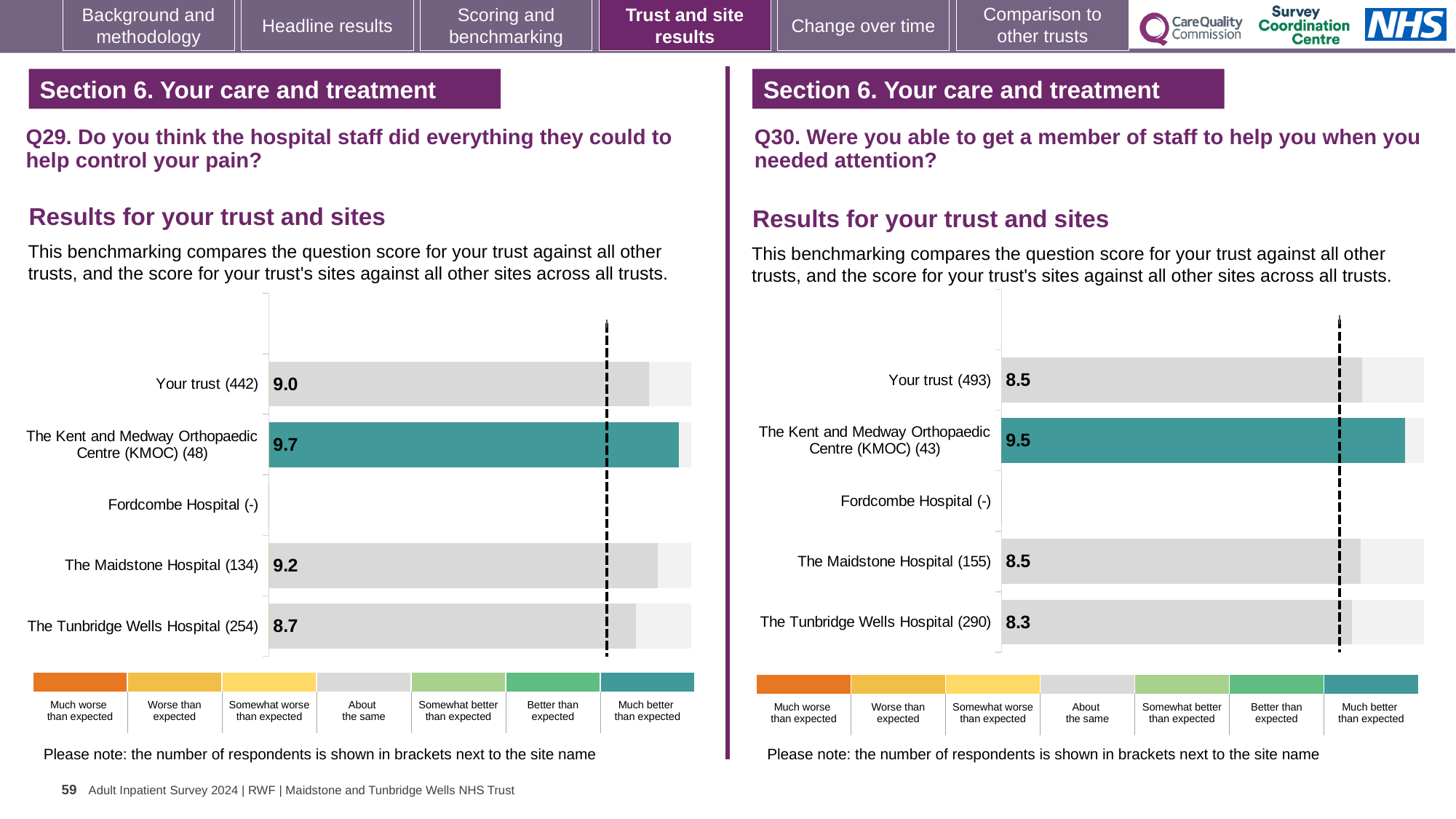
In the Q30 chart on the right, what is the score for The Kent and Medway Orthopaedic Centre (KMOC) (43)? 9.5 In the Q29 chart on the left, what is the score for The Tunbridge Wells Hospital (254)? 8.7 In the Q29 chart on the left, which has the higher score: The Maidstone Hospital or Your trust? The Maidstone Hospital In the Q30 chart on the right, what is the score for The Maidstone Hospital (155)? 8.5 In the Q29 chart on the left, what is the score for Your trust (442)? 9.0 In the Q29 chart on the left, which site's bar is coloured teal, indicating 'Much better than expected'? The Kent and Medway Orthopaedic Centre (KMOC) (48) In the Q29 chart on the left, what is the difference between the scores for The Kent and Medway Orthopaedic Centre (KMOC) and The Tunbridge Wells Hospital? 1.0 In the Q30 chart on the right, which site has the lowest score among those with a score shown? The Tunbridge Wells Hospital (290) What kind of chart is used for the Q30 results on the right? Bar chart In the Q29 chart on the left, which site has the highest score? The Kent and Medway Orthopaedic Centre (KMOC) (48) In the Q30 chart on the right, what is the difference between the scores for Your trust and The Tunbridge Wells Hospital? 0.2 How many sites or trust rows are listed in the Q29 chart on the left? 5